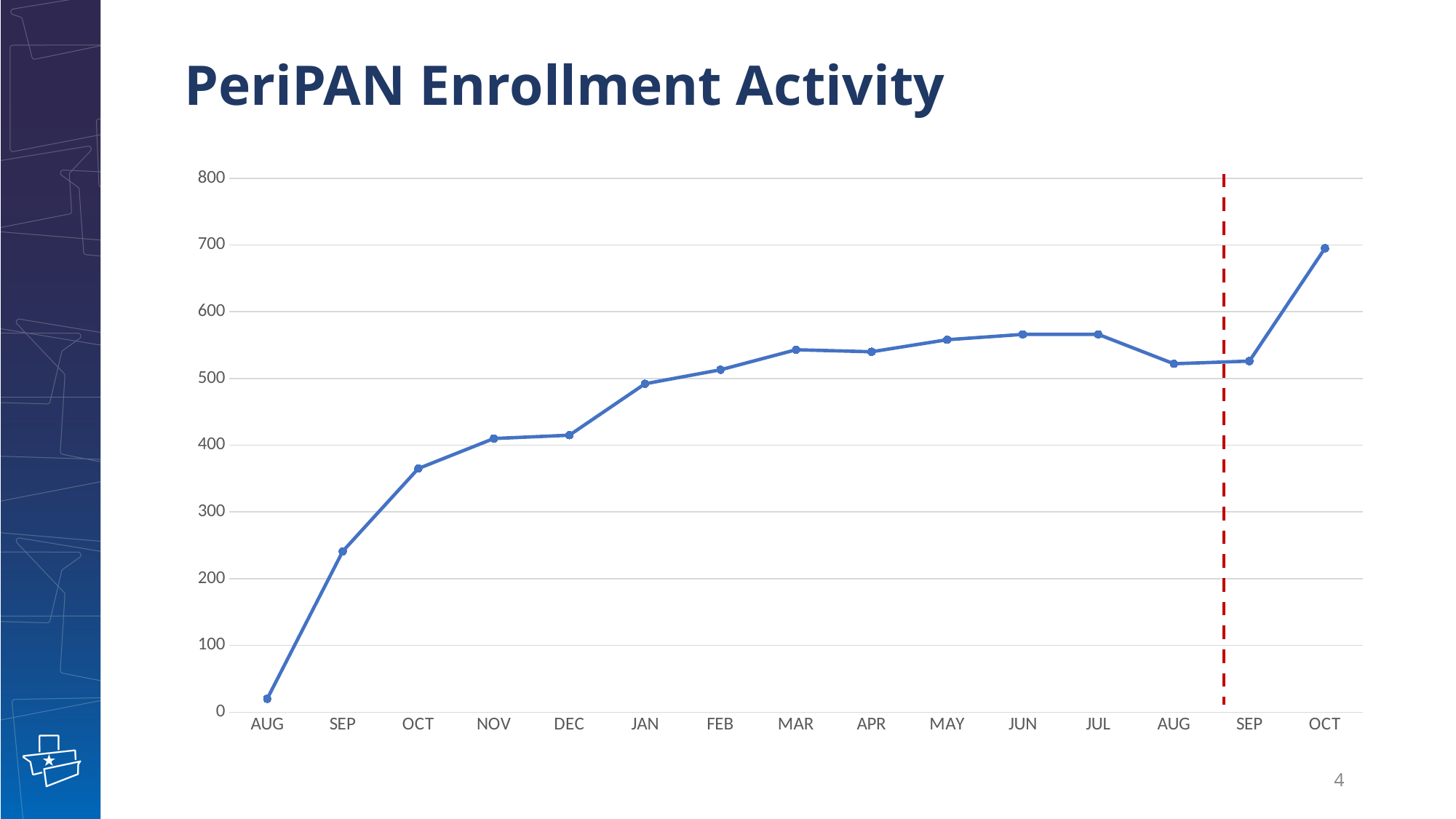
Is the value for JUL greater or less than 600? less What kind of chart is shown on the slide? line chart How many data points are plotted on the line? 15 Is the value for the final OCT greater or less than 600? greater Is the value for the first SEP greater or less than 200? greater Which month has the lowest value on the chart? AUG (the first point) Overall, do the values rise or fall from the first AUG to the final OCT? rise Between which two months is the red dashed vertical line drawn? between the second AUG and the second SEP Which month has the highest value on the chart? OCT (the last point) What is the title of the chart? PeriPAN Enrollment Activity Which is larger, the value for DEC or the value for JAN? JAN